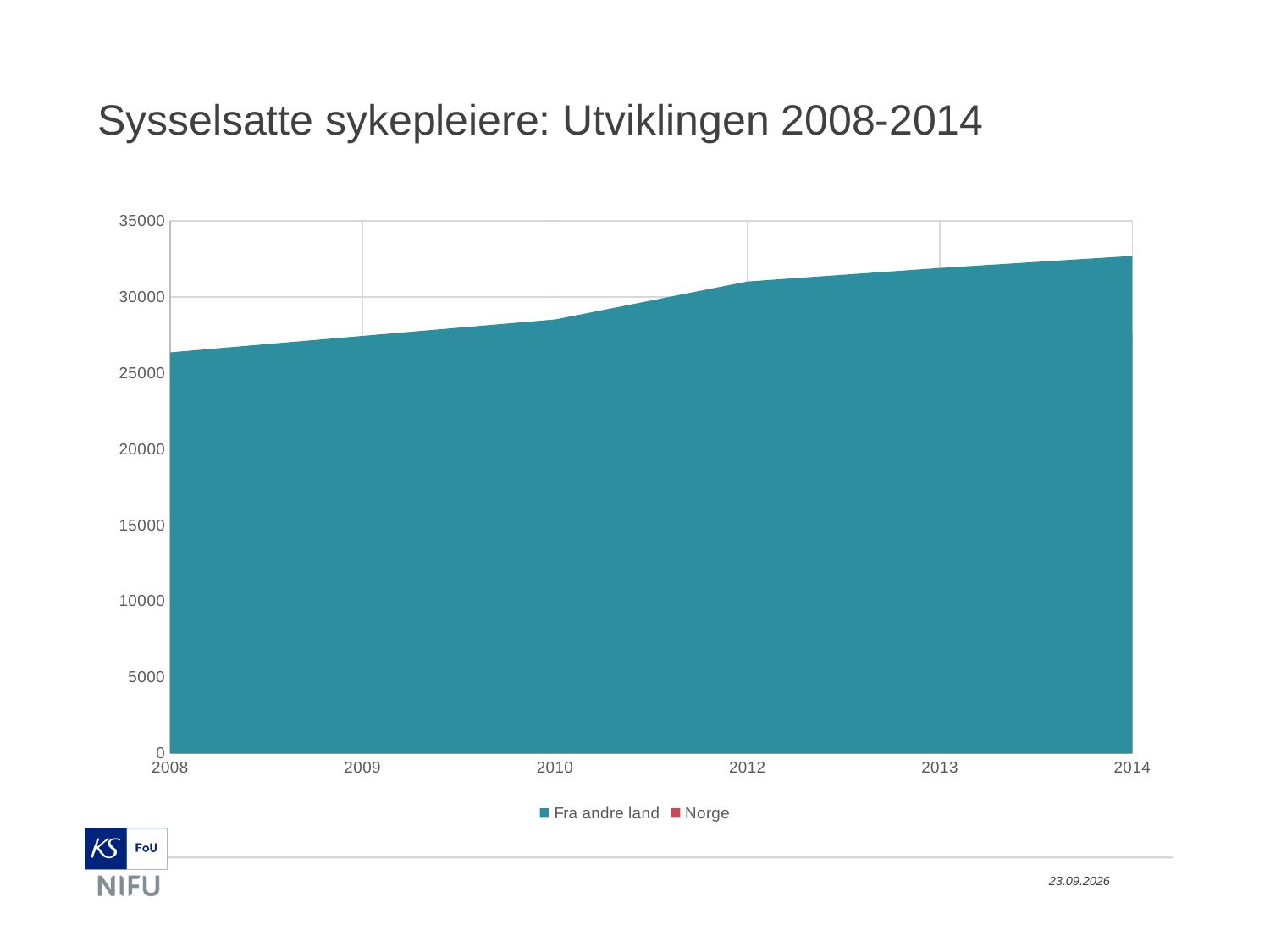
Is the value for Fra andre land in 2014 greater or less than 35000? less Which year has the highest value for Fra andre land? 2014 Is the value for Fra andre land in 2008 greater or less than 25000? greater Is the value for Fra andre land in 2010 greater or less than 30000? less Which series are listed in the legend? Fra andre land, Norge How many series does the legend list? 2 What kind of chart is shown on the slide? area chart What is the title of the chart on the slide? Sysselsatte sykepleiere: Utviklingen 2008-2014 Do the values for Fra andre land rise or fall from 2008 to 2014? rise How many years are shown on the x axis? 6